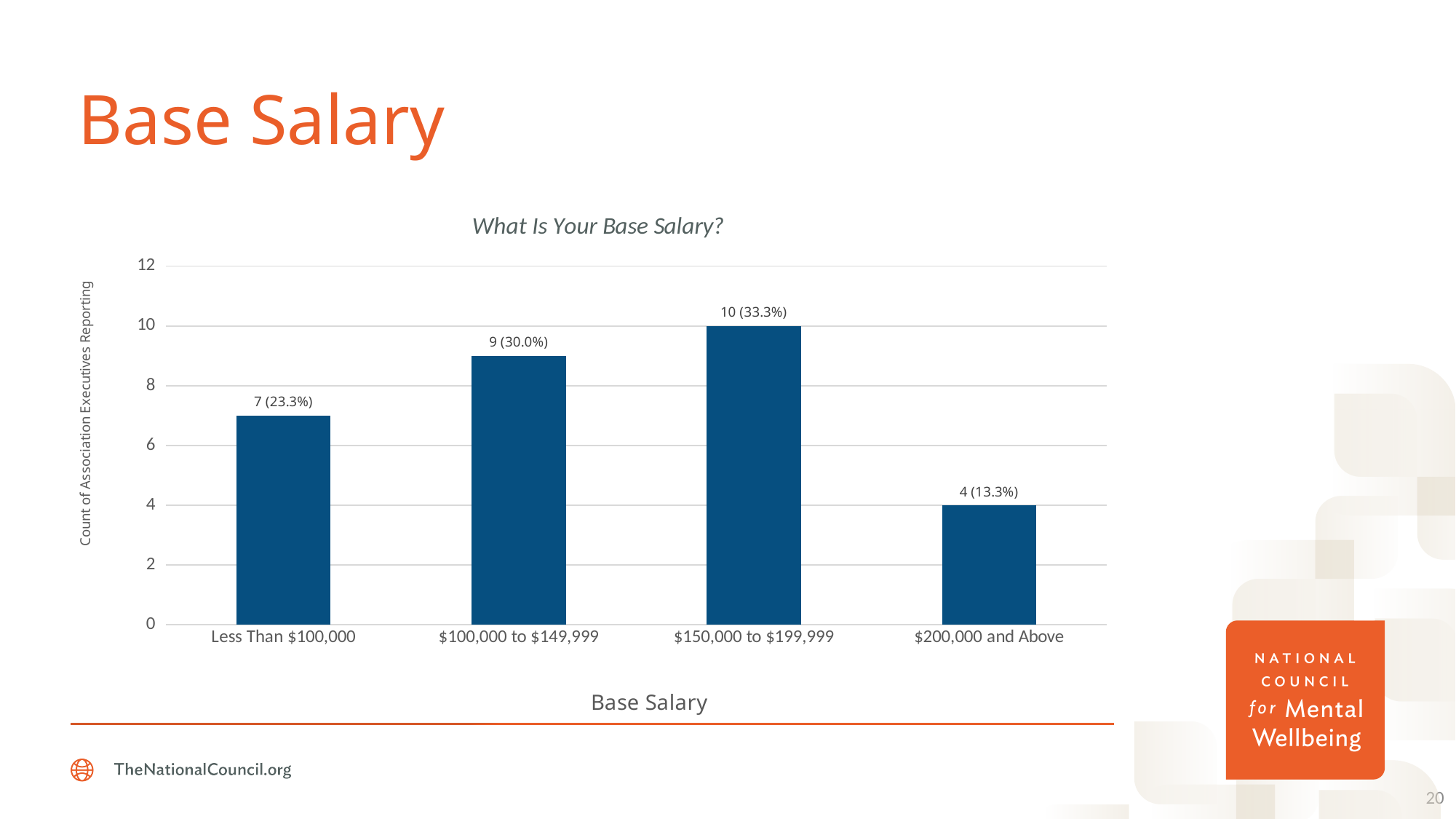
Which has a higher count: Less Than $100,000 or $100,000 to $149,999? $100,000 to $149,999 What is the total count across all four base salary categories? 30 What is the label of the vertical axis? Count of Association Executives Reporting How many association executives reported a base salary of less than $100,000? 7 What percentage of respondents reported a base salary of $150,000 to $199,999? 33.3% How many base salary categories are shown on the chart? 4 What is the count for the $200,000 and Above category? 4 What kind of chart is shown on the slide? Bar chart What is the difference in count between the $150,000 to $199,999 category and the $200,000 and Above category? 6 Which base salary category has the lowest count? $200,000 and Above What is the title of the chart? What Is Your Base Salary? Which base salary category has the highest count? $150,000 to $199,999